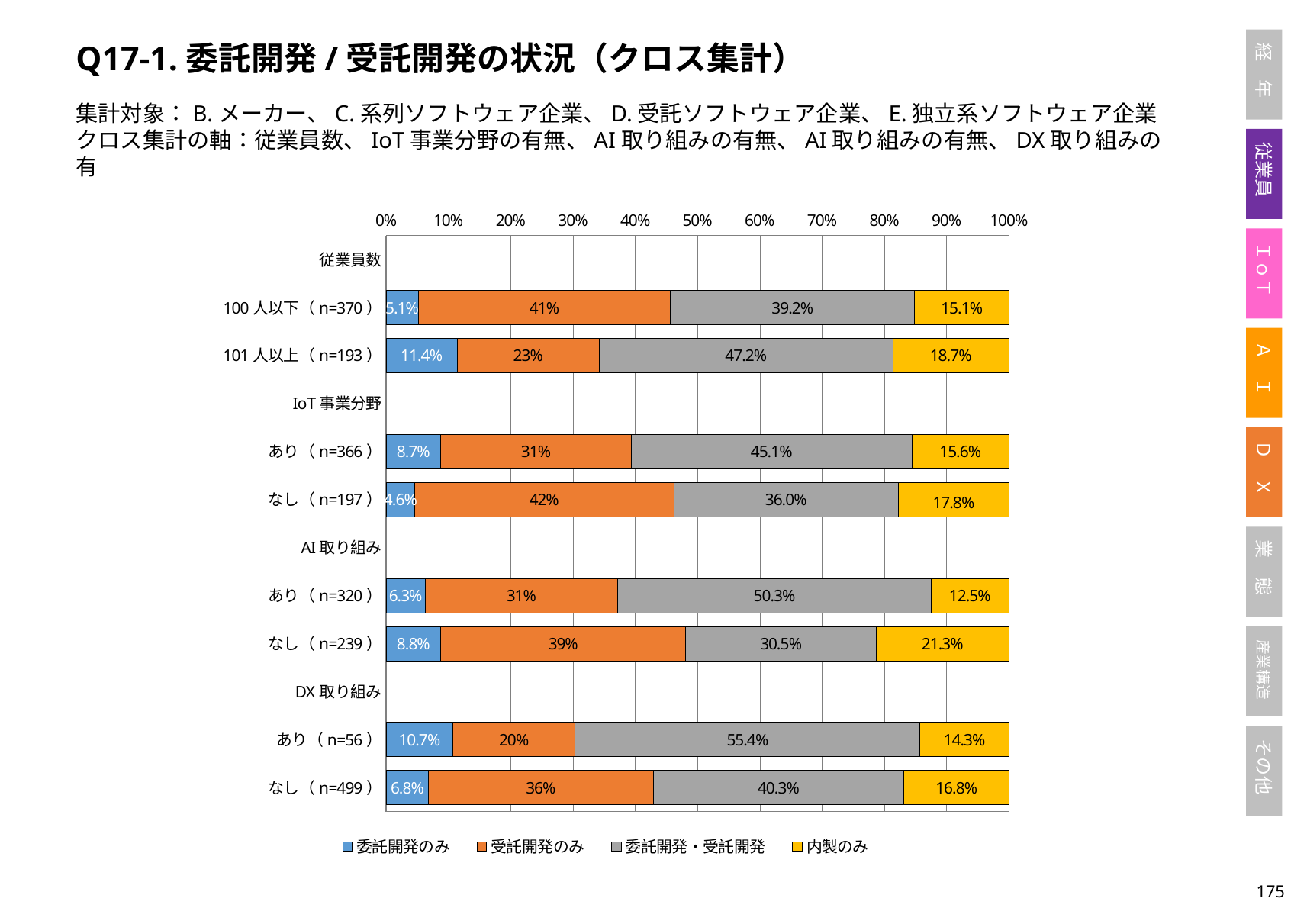
Which colour represents 内製のみ in the chart? Yellow What type of chart is shown on the slide? Stacked bar chart What is the value of 内製のみ for AI取り組み なし（n=239）? 21.3% Which is larger: the 受託開発のみ value for AI取り組み あり（n=320）or for AI取り組み なし（n=239）? AI取り組み なし（n=239） What is the value of 委託開発・受託開発 for 101人以上（n=193）? 47.2% Which category has the lowest value for 委託開発のみ? IoT事業分野 なし（n=197） How many series does the legend list? 4 What is the value of 委託開発のみ for DX取り組み あり（n=56）? 10.7% What is the difference between the 内製のみ values for 101人以上（n=193）and 100人以下（n=370）? 3.6% What is the value of 受託開発のみ for IoT事業分野 なし（n=197）? 42% How many data bars (categories with plotted values) are shown in the chart? 8 Which category has the highest value for 委託開発・受託開発? DX取り組み あり（n=56）